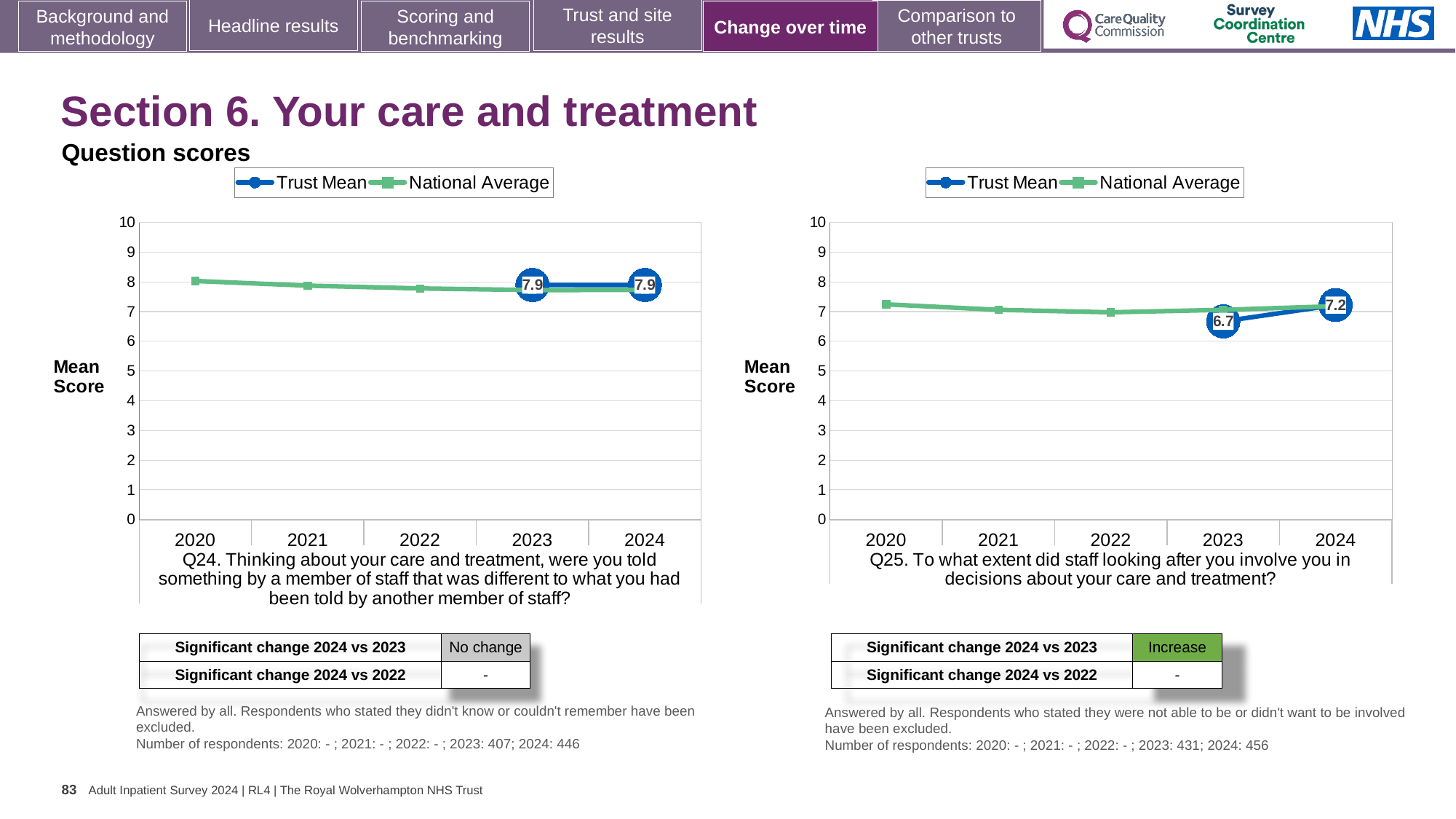
How many years are shown on the x axis of the Q24 chart on the left? 5 In the Q24 chart on the left, what is the Trust Mean value for 2024? 7.9 What kind of chart is the Q24 chart on the left? line chart In the Q25 chart on the right, which year has the higher Trust Mean, 2023 or 2024? 2024 In the Q25 chart on the right, by how much did the Trust Mean change from 2023 to 2024? 0.5 In the Q24 chart on the left, what is the Trust Mean value for 2023? 7.9 In the Q25 chart on the right, what is the Trust Mean value for 2023? 6.7 In the Q25 chart on the right, what is the Trust Mean value for 2024? 7.2 In the Q25 chart on the right, is the National Average value for 2022 greater or less than 8? less How many series does the legend of the Q25 chart on the right list? 2 In the Q24 chart on the left, is the National Average value for 2020 greater or less than 7? greater In the Q25 chart on the right, does the Trust Mean rise or fall from 2023 to 2024? rise